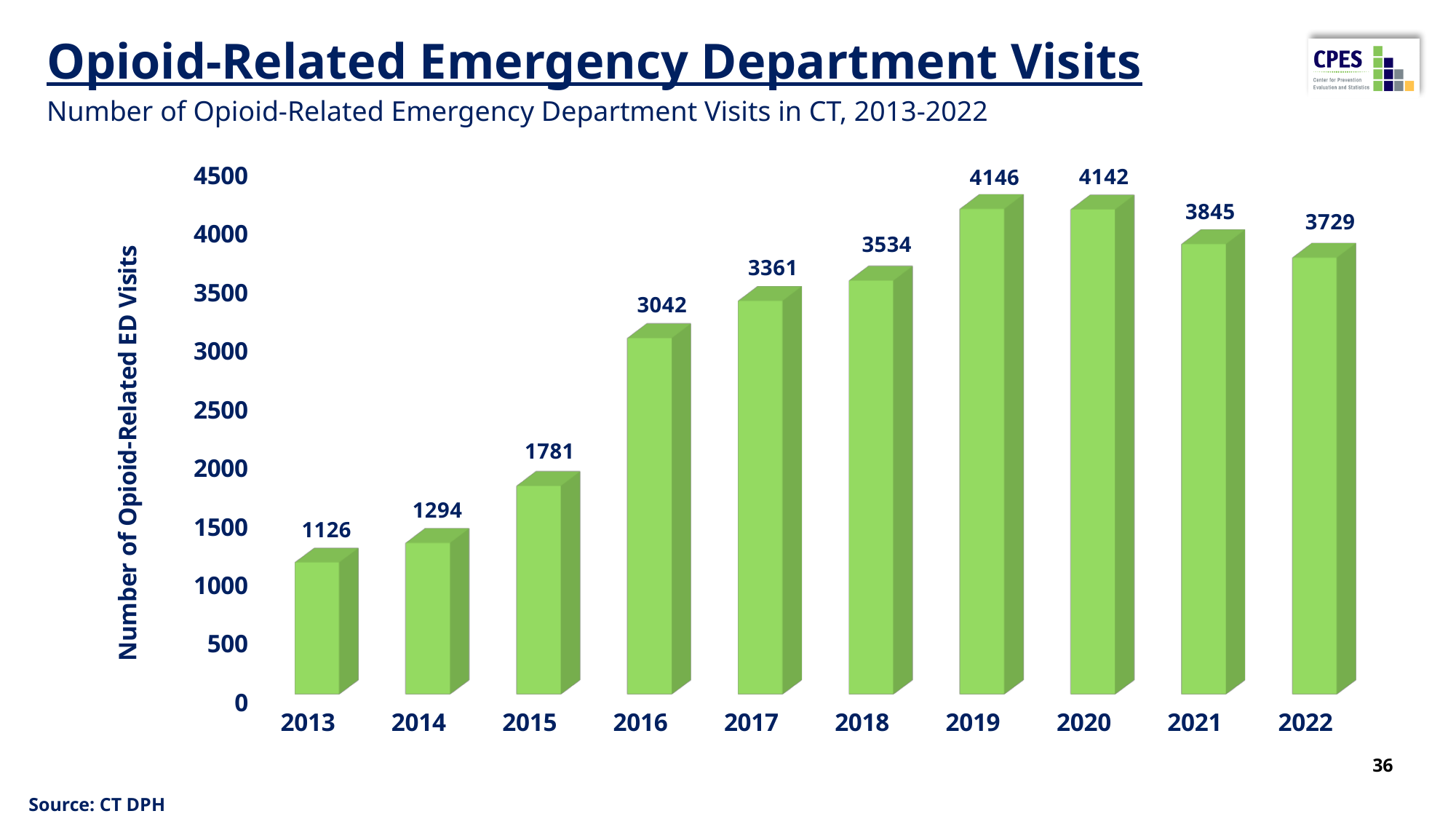
What is the label on the vertical axis of the chart? Number of Opioid-Related ED Visits How many opioid-related emergency department visits were there in CT in 2016? 3042 What is the difference in opioid-related ED visits between 2019 and 2013? 3020 What type of chart is used to show the opioid-related ED visits? Bar chart Which year had the lowest number of opioid-related ED visits? 2013 Which year had more opioid-related ED visits, 2015 or 2016? 2016 How many years are shown on the x axis of the chart? 10 Which year had the highest number of opioid-related ED visits? 2019 By how much did opioid-related ED visits fall from 2021 to 2022? 116 What source is cited for the chart data? CT DPH Did opioid-related ED visits rise or fall from 2013 to 2019? Rise What is the number of opioid-related ED visits shown for 2022? 3729